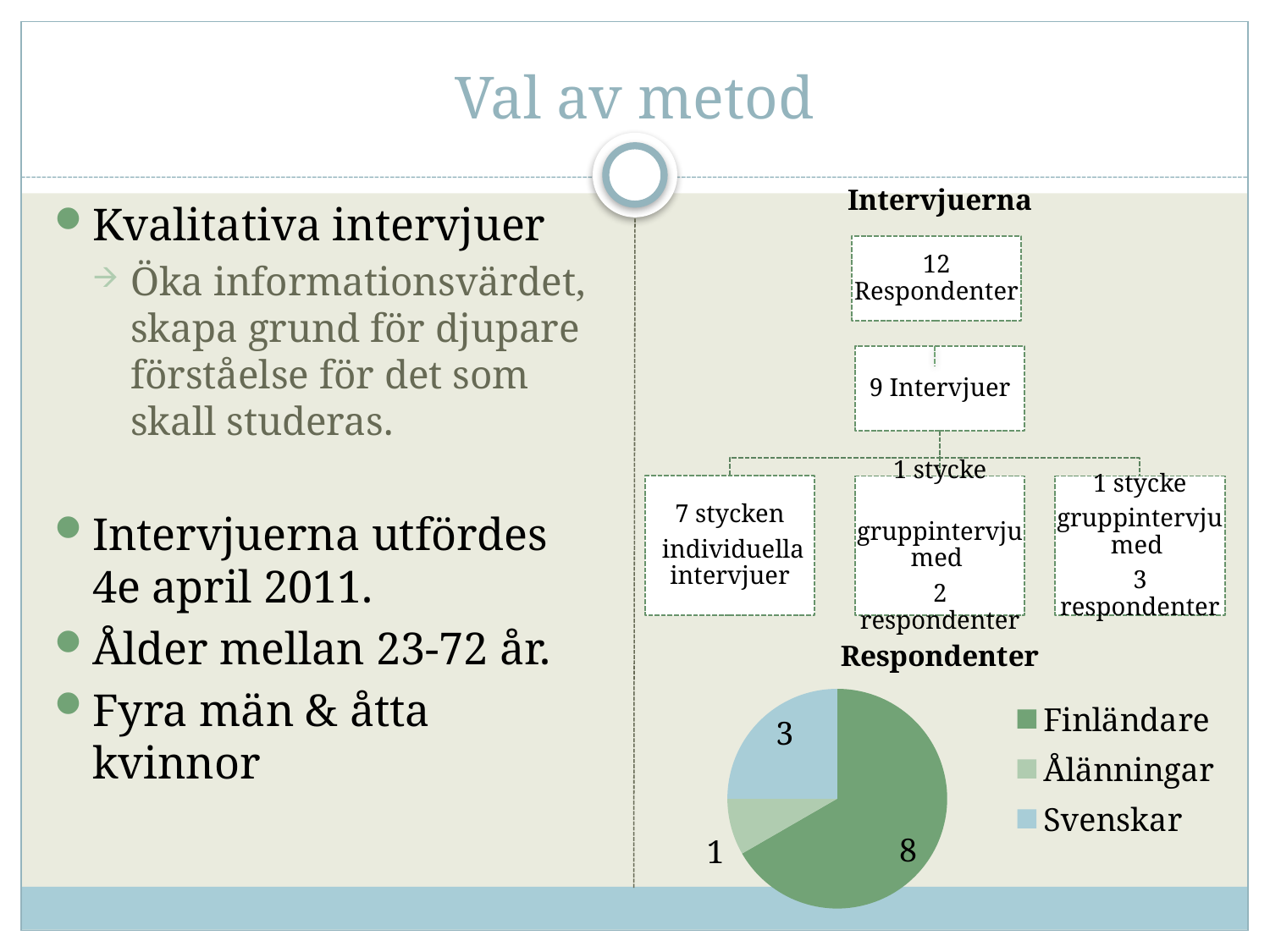
In the "Respondenter" pie chart, what is the value for Ålänningar? 1 In the "Respondenter" pie chart, what is the difference between the values for Svenskar and Ålänningar? 2 In the "Respondenter" pie chart, which category has the largest slice? Finländare In the "Respondenter" pie chart, what is the value for Finländare? 8 How many categories does the "Respondenter" pie chart show? 3 In the "Respondenter" pie chart, what is the value for Svenskar? 3 In the "Respondenter" pie chart, what is the difference between the values for Finländare and Svenskar? 5 In the "Respondenter" pie chart, what colour is the Svenskar slice? light blue What is the total of all slices in the "Respondenter" pie chart? 12 In the "Respondenter" pie chart, which category has the smallest slice? Ålänningar What kind of chart is the "Respondenter" chart? pie chart In the "Respondenter" pie chart, which is larger, Svenskar or Ålänningar? Svenskar